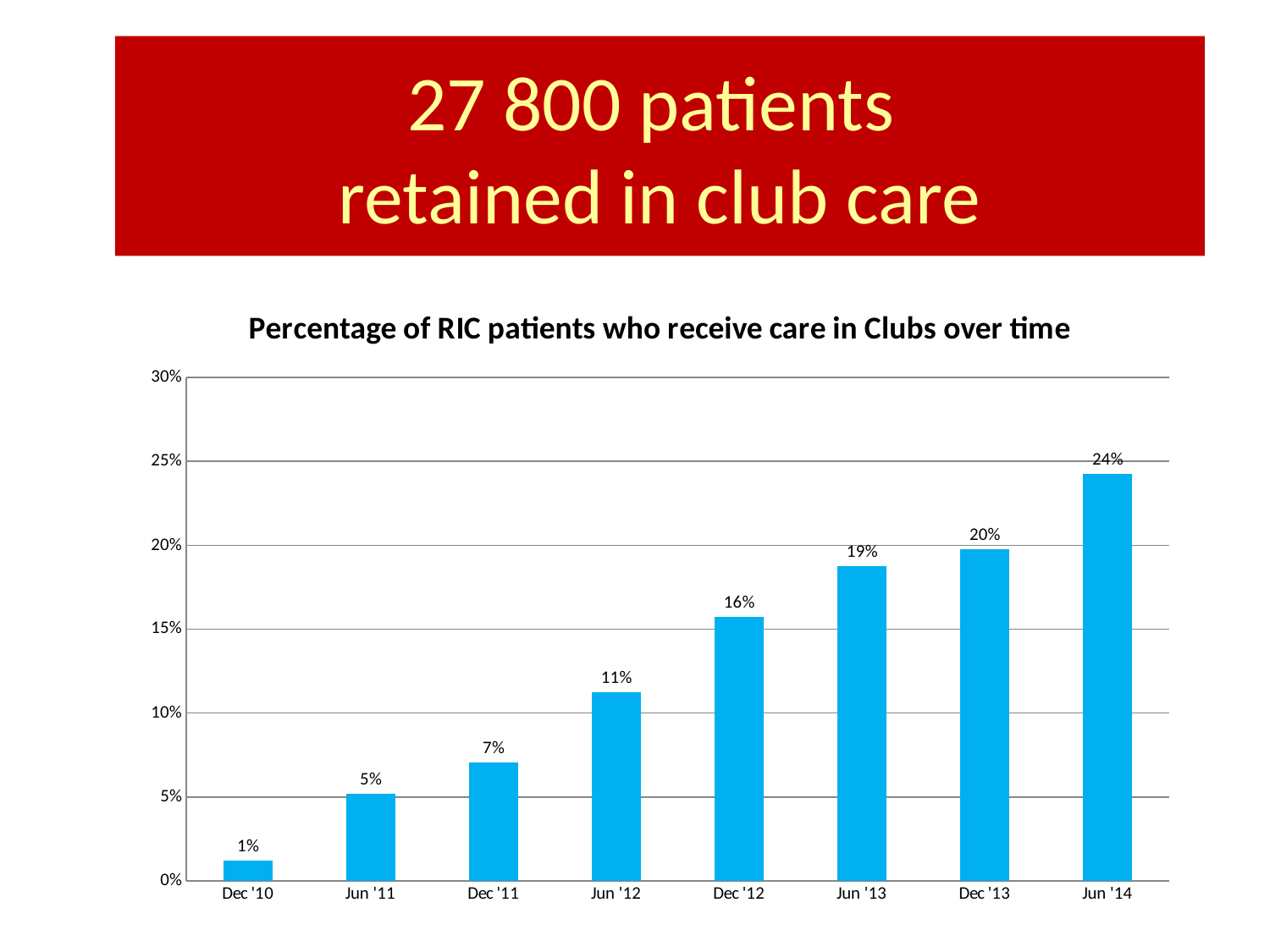
Which period has the highest percentage? Jun '14 What is the value for Dec '10? 1% Which period has the lowest percentage? Dec '10 What is the title of the chart? Percentage of RIC patients who receive care in Clubs over time Do the values rise or fall from Dec '10 to Jun '14? Rise What is the difference between the values for Jun '14 and Dec '12? 8% What kind of chart is this? Bar chart Which is larger, the value for Jun '13 or the value for Dec '11? Jun '13 How many periods are shown on the x axis? 8 What is the value for Jun '12? 11% Is the value for Dec '12 greater or less than 15%? greater What is the value for Dec '13? 20%